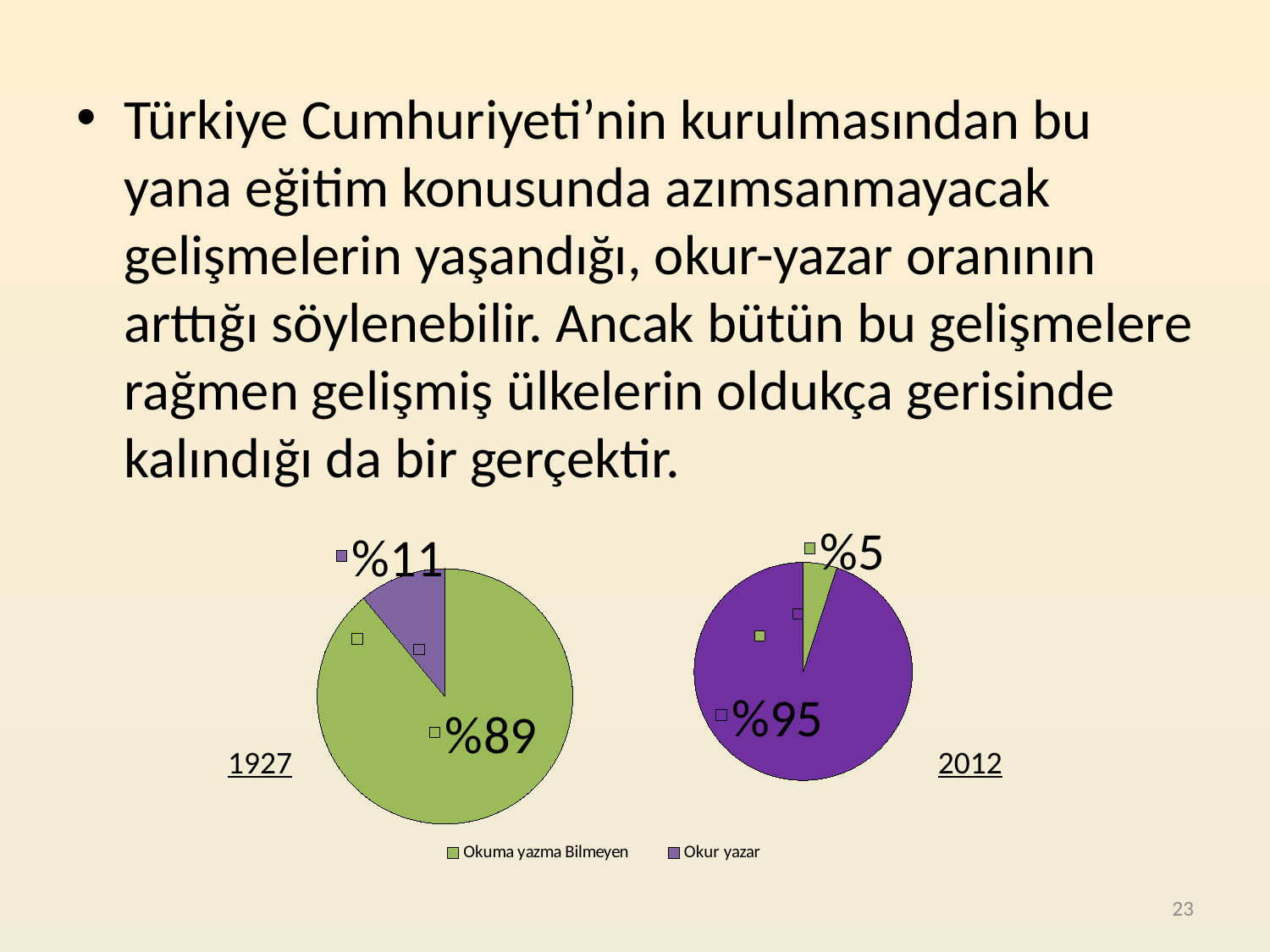
Which is larger: the Okur yazar value in the 1927 chart or the Okur yazar value in the 2012 chart? 2012 In the 1927 pie chart, what is the value for Okur yazar? %11 In the 1927 pie chart, what is the difference between the Okuma yazma Bilmeyen and Okur yazar values? %78 In the 1927 pie chart, which slice is the largest? Okuma yazma Bilmeyen In the 1927 pie chart, what is the value for Okuma yazma Bilmeyen? %89 In the 2012 pie chart, which slice is the smallest? Okuma yazma Bilmeyen How many entries does the legend below the charts list? 2 Which colour represents Okur yazar in the legend? purple What type of chart is the 1927 chart? pie chart In the 2012 pie chart, what is the value for Okur yazar? %95 How many slices does the 2012 pie chart have? 2 In the 2012 pie chart, what is the value for Okuma yazma Bilmeyen? %5